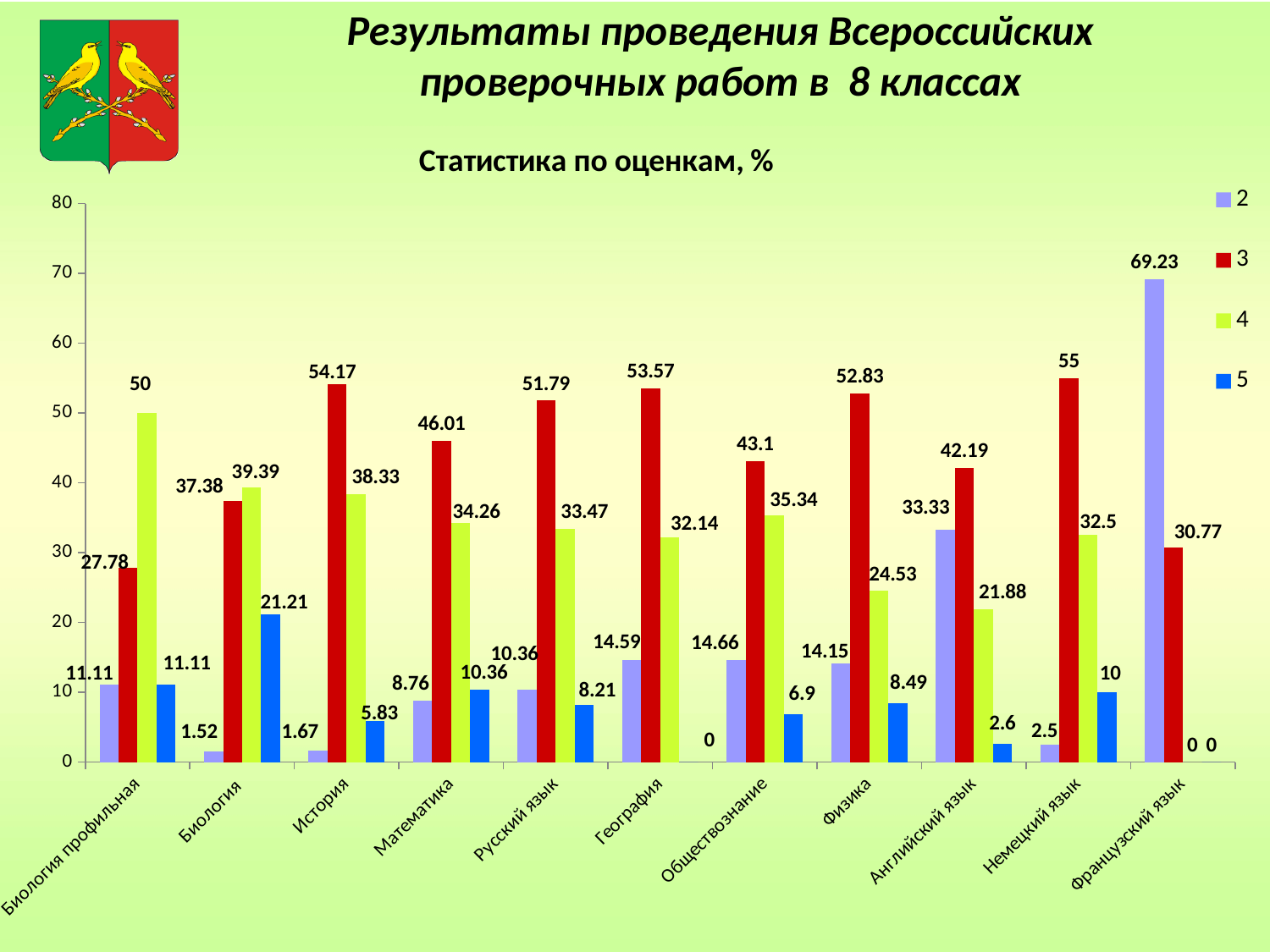
Which subject has the highest value for series 2? Французский язык Which is larger for Биология: the series 3 value or the series 4 value? series 4 (39.39) What is the title of the chart? Статистика по оценкам, % How many subject categories are shown on the x axis? 11 How many series does the legend list? 4 What is the value of series 4 for Биология профильная? 50 What is the value of series 3 for История? 54.17 What is the difference between the series 3 and series 4 values for Немецкий язык? 22.5 What is the value of series 2 for Французский язык? 69.23 What type of chart is shown on the slide? bar chart Which subject has the lowest value for series 3? Биология профильная What is the value of series 5 for Биология? 21.21